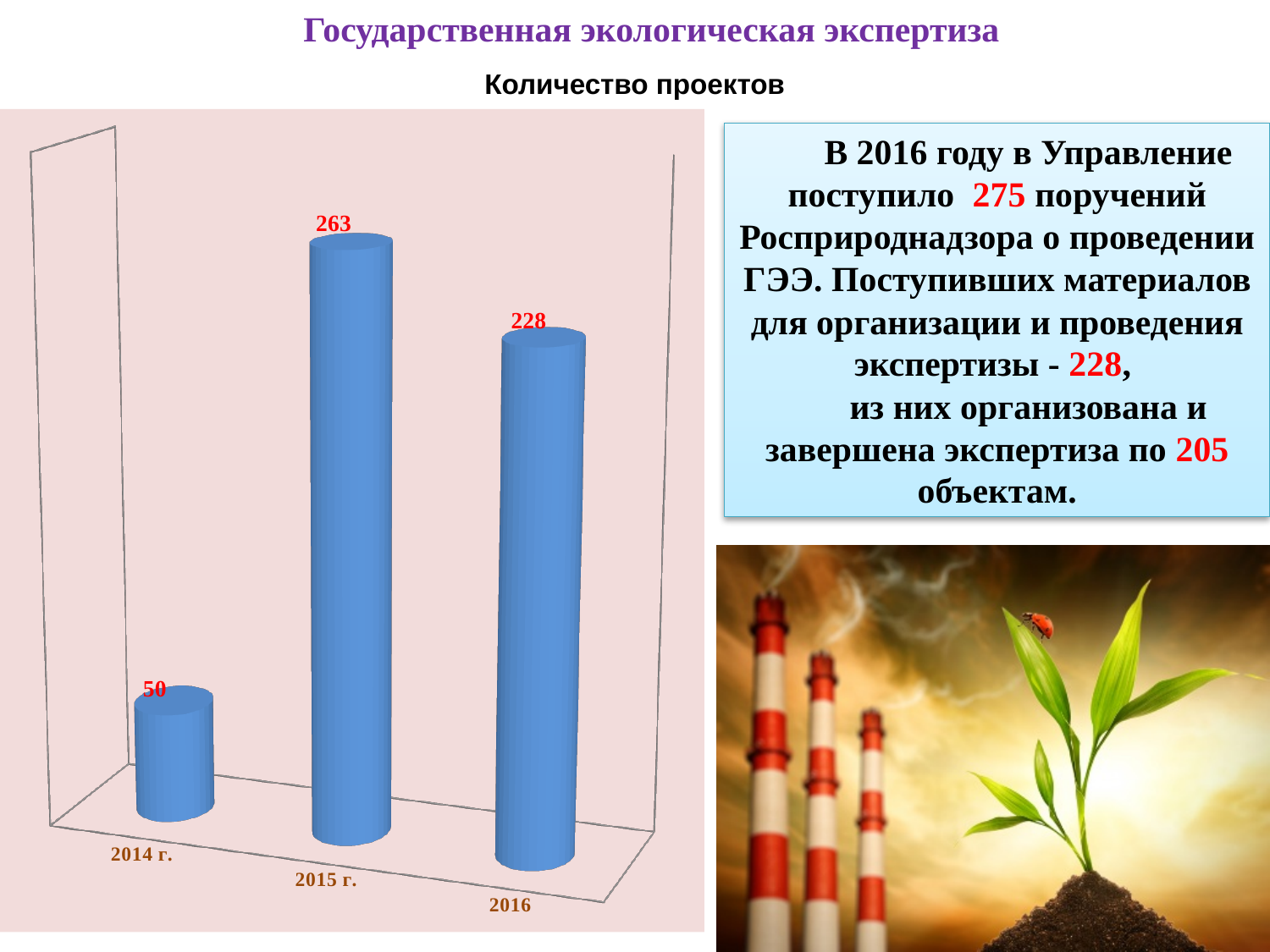
What is the value for 2014 г.? 50 How many categories are shown in the chart? 3 Does the value rise or fall from 2015 г. to 2016? fall What kind of chart is shown on the slide? bar chart What is the value for 2016? 228 What is the difference between the values for 2015 г. and 2014 г.? 213 Which year has the lowest value? 2014 г. What is the difference between the values for 2015 г. and 2016? 35 What is the title of the chart? Количество проектов Which is larger, the value for 2016 or the value for 2014 г.? 2016 What is the value for 2015 г.? 263 Which year has the highest value? 2015 г.